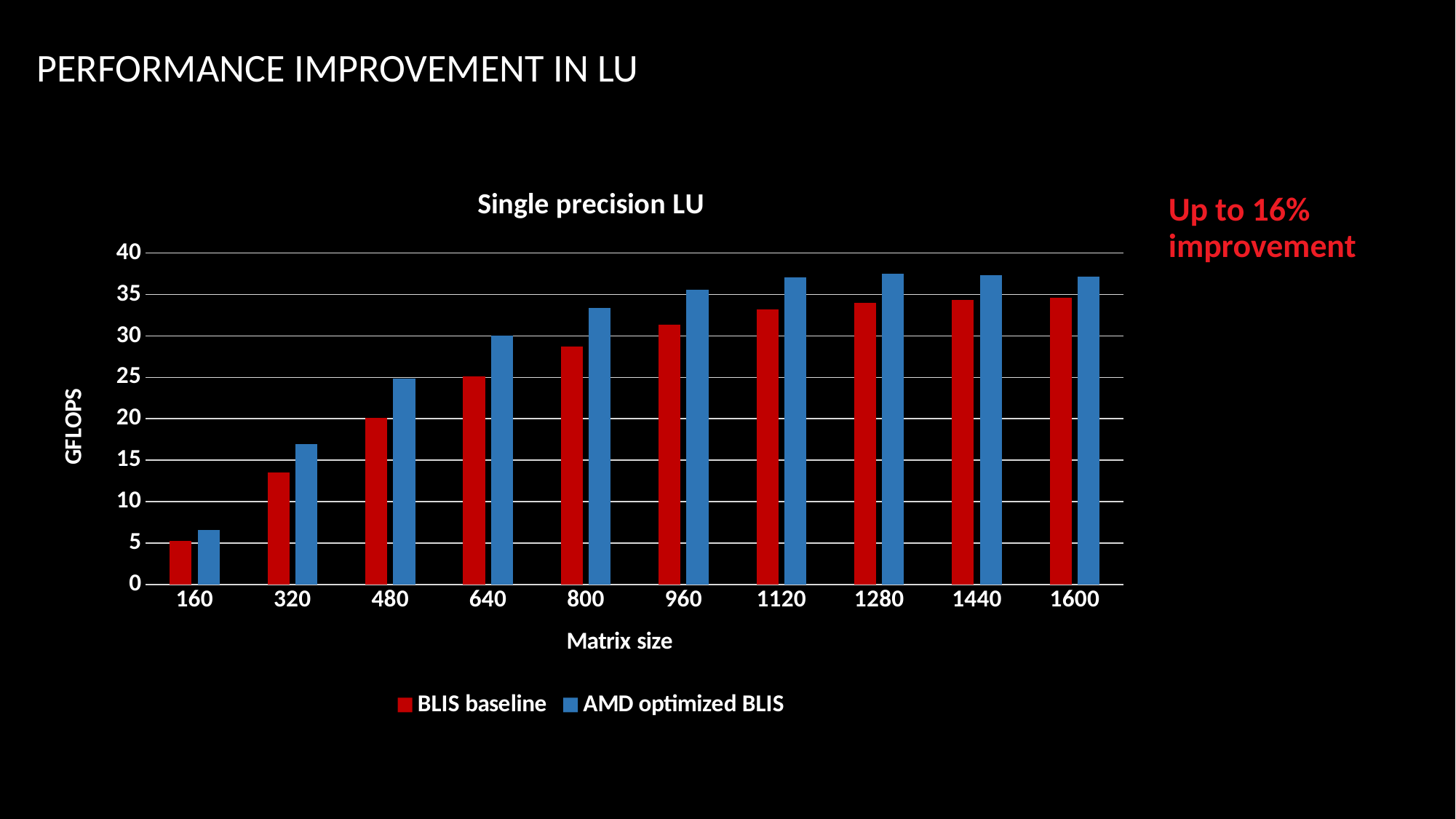
Is the BLIS baseline value for matrix size 800 greater or less than 25? greater How many series does the legend list? 2 How many matrix sizes are shown on the x axis? 10 What is the title of the chart? Single precision LU Which matrix size has the lowest AMD optimized BLIS value? 160 Is the BLIS baseline value for matrix size 320 greater or less than 15? less What kind of chart is shown on the slide? bar chart Do the AMD optimized BLIS values generally rise or fall as matrix size increases from 160 to 1280? rise Is the AMD optimized BLIS value for matrix size 320 greater or less than 15? greater Which matrix size has the lowest BLIS baseline value? 160 At matrix size 640, which series has the larger value, BLIS baseline or AMD optimized BLIS? AMD optimized BLIS